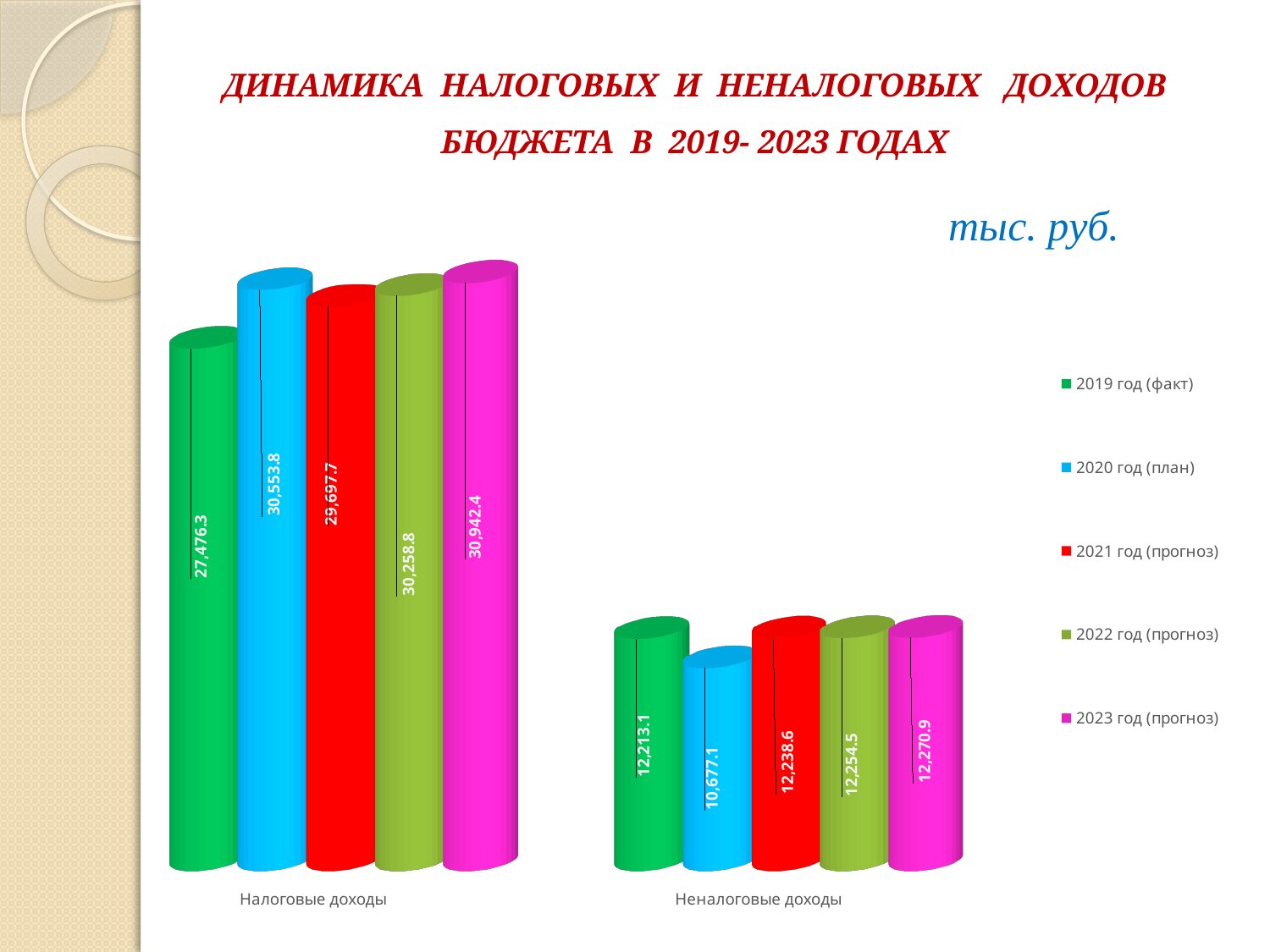
How many series does the legend list? 5 What is the difference between the 2023 год (прогноз) and 2019 год (факт) values for Налоговые доходы? 3,466.1 Which year has the lowest value for Налоговые доходы? 2019 год (факт) What kind of chart is shown on the slide? Bar chart What is the value for Неналоговые доходы in 2020 год (план)? 10,677.1 Which year has the highest value for Налоговые доходы? 2023 год (прогноз) What is the value for Налоговые доходы in 2022 год (прогноз)? 30,258.8 How many categories are shown on the x axis? 2 Which is larger for Налоговые доходы: the 2020 год (план) value or the 2021 год (прогноз) value? 2020 год (план) Which year has the lowest value for Неналоговые доходы? 2020 год (план) What is the difference between the 2023 год (прогноз) and 2020 год (план) values for Неналоговые доходы? 1,593.8 What is the value for Налоговые доходы in 2019 год (факт)? 27,476.3